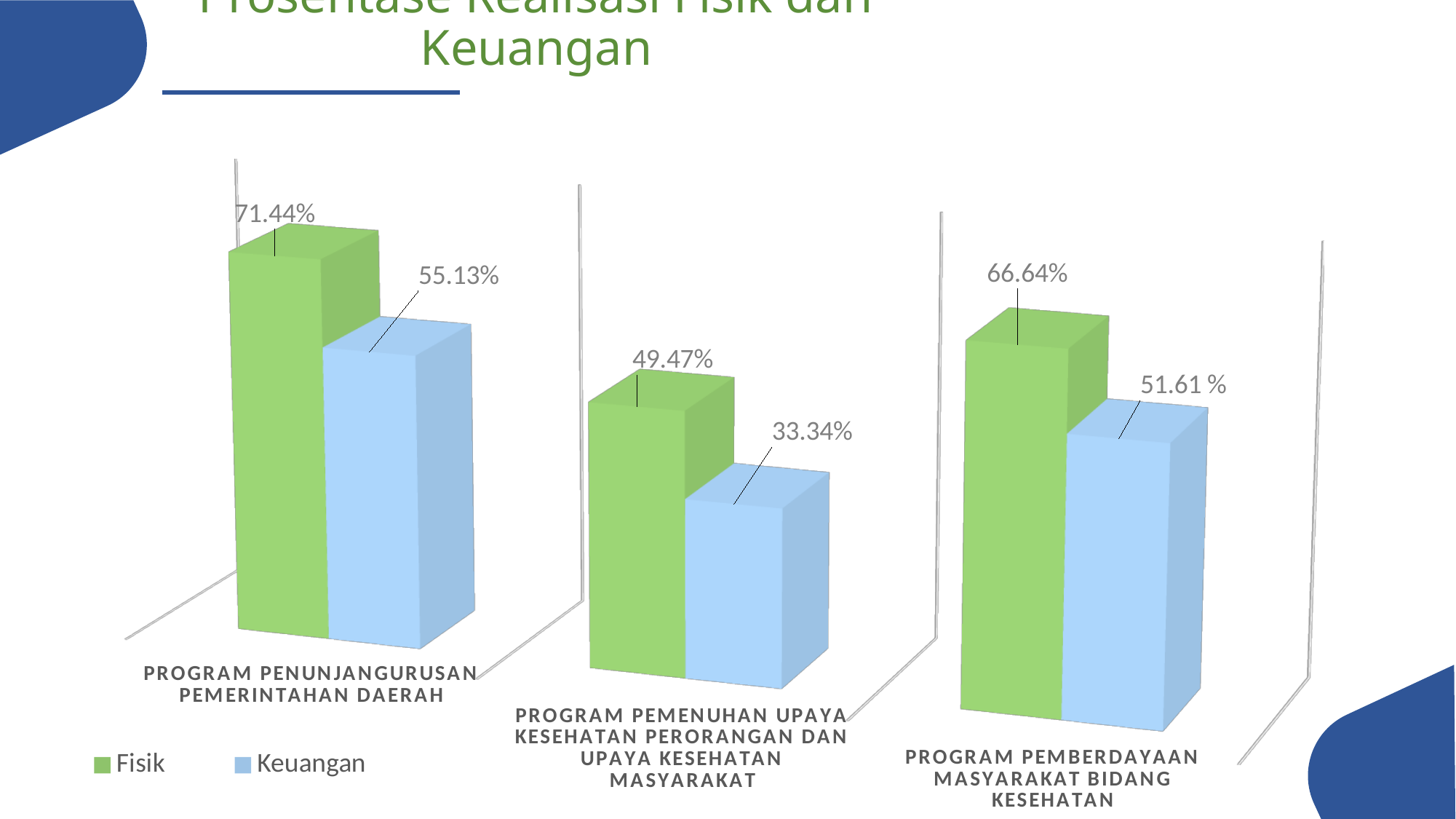
What is the Fisik value for Program Pemberdayaan Masyarakat Bidang Kesehatan? 66.64% What is the Keuangan value for Program Pemberdayaan Masyarakat Bidang Kesehatan? 51.61 % What is the Fisik value for Program Pemenuhan Upaya Kesehatan Perorangan dan Upaya Kesehatan Masyarakat? 49.47% Which is larger for Program Pemberdayaan Masyarakat Bidang Kesehatan, the Fisik value or the Keuangan value? Fisik What is the Keuangan value for Program Penunjang Urusan Pemerintahan Daerah? 55.13% How many series does the legend list? 2 What is the difference between the Fisik and Keuangan values for Program Penunjang Urusan Pemerintahan Daerah? 16.31% Which program has the lowest Keuangan value? Program Pemenuhan Upaya Kesehatan Perorangan dan Upaya Kesehatan Masyarakat Which program has the highest Fisik value? Program Penunjang Urusan Pemerintahan Daerah What kind of chart is shown on the slide? Bar chart What is the Keuangan value for Program Pemenuhan Upaya Kesehatan Perorangan dan Upaya Kesehatan Masyarakat? 33.34% What is the Fisik value for Program Penunjang Urusan Pemerintahan Daerah? 71.44%